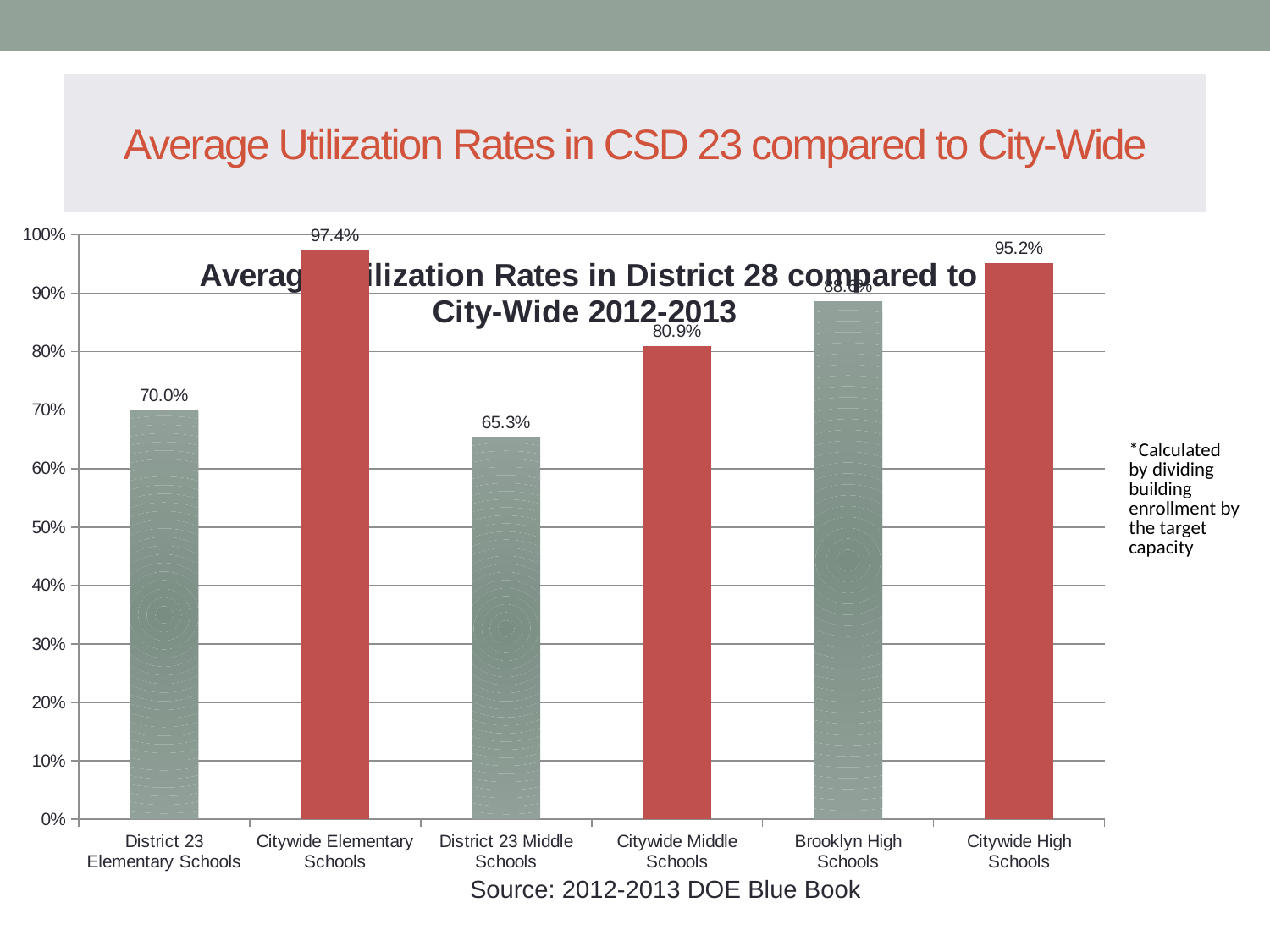
Which category has the lowest average utilization rate? District 23 Middle Schools What is the average utilization rate for Citywide Middle Schools? 80.9% What is the difference between the utilization rates of Citywide Elementary Schools and District 23 Elementary Schools? 27.4 percentage points Which category has the highest average utilization rate? Citywide Elementary Schools What is the average utilization rate for District 23 Elementary Schools? 70.0% Is the value for Brooklyn High Schools greater or less than 80%? greater How many categories are shown on the x axis of the chart? 6 What is the average utilization rate for Citywide Elementary Schools? 97.4% What is the average utilization rate for Citywide High Schools? 95.2% What kind of chart is shown on the slide? bar chart Which has a higher utilization rate, District 23 Middle Schools or Citywide Middle Schools? Citywide Middle Schools What is the average utilization rate for District 23 Middle Schools? 65.3%